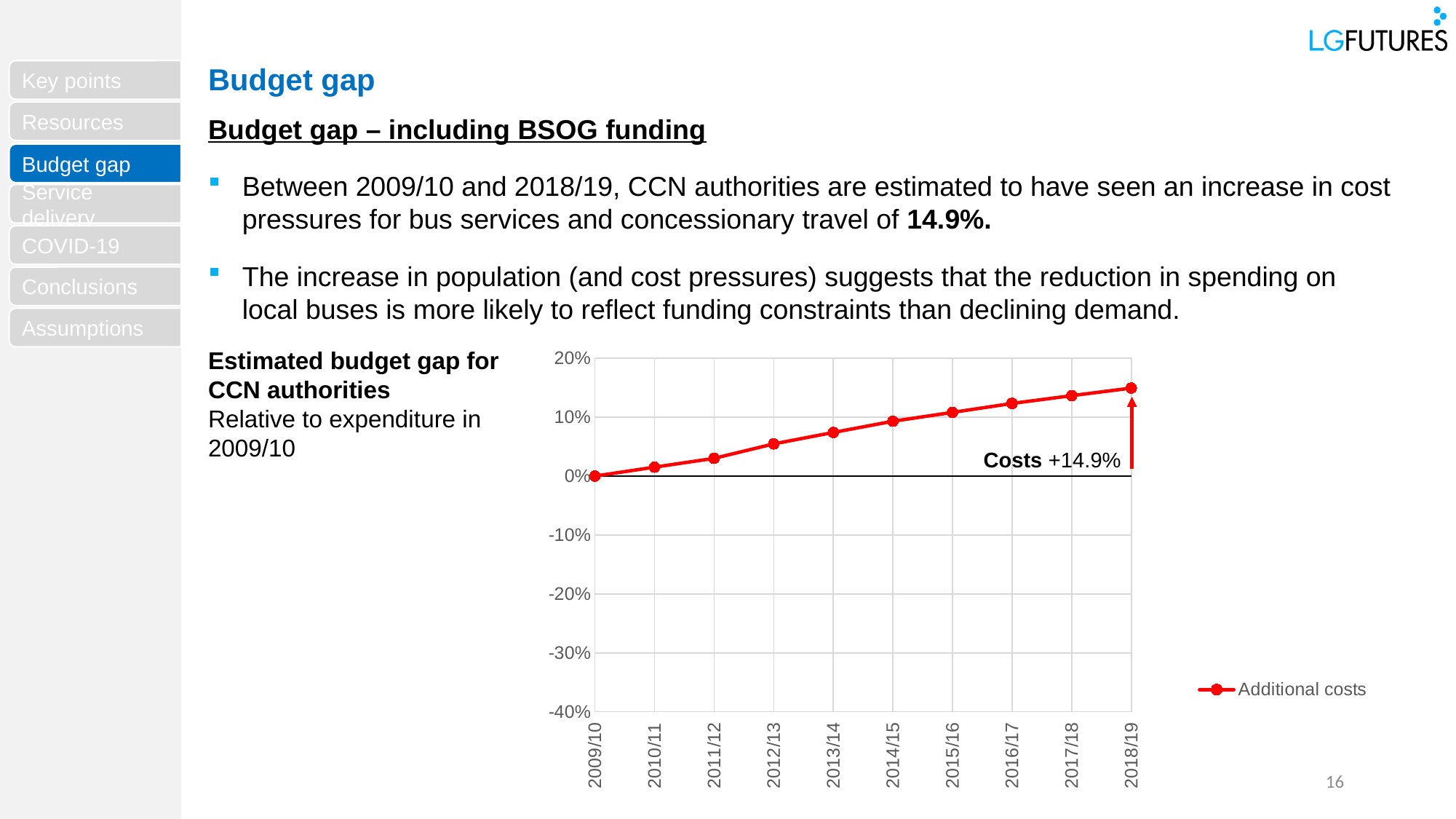
What kind of chart is shown on the slide? line chart Do the Additional costs values rise or fall from 2009/10 to 2018/19? rise Is the value for Additional costs in 2017/18 greater or less than 10%? greater What is the value of Additional costs for 2018/19, as annotated on the chart? +14.9% What is the name of the series shown in the chart legend? Additional costs Which year has the highest value for Additional costs? 2018/19 Which year has the lowest value for Additional costs? 2009/10 How many years are plotted along the x axis of the chart? 10 Which is larger: the Additional costs value for 2016/17 or for 2012/13? 2016/17 Is the value for Additional costs in 2013/14 greater or less than 10%? less What is the value of Additional costs for 2009/10? 0% How many series does the chart legend list? 1